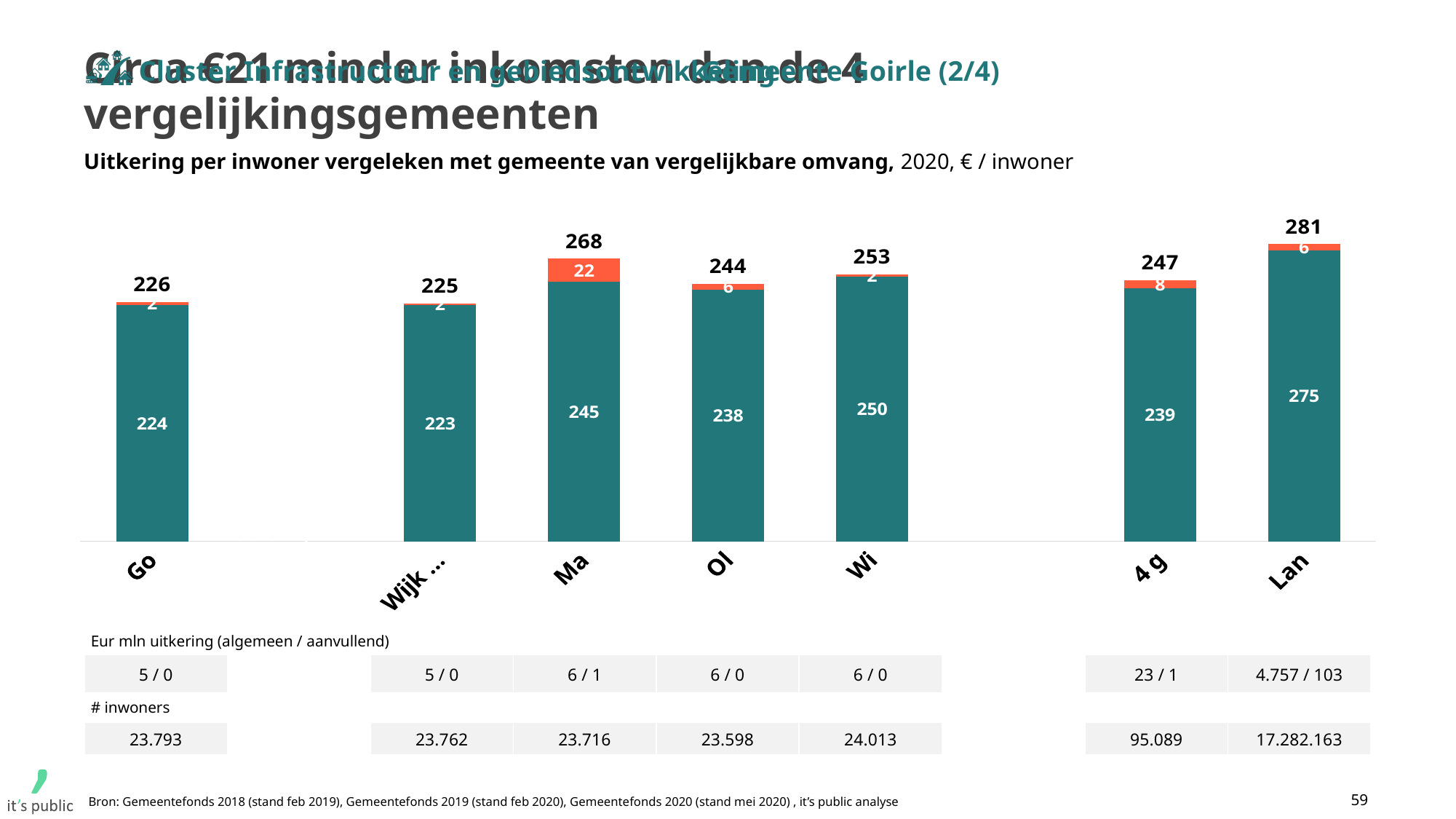
What is the value of the teal (lower) segment of the bar for Go? 224 What is the total value printed above the bar for Ma? 268 What kind of chart is shown on the slide? stacked bar chart What is the value of the orange (upper) segment of the bar for Ma? 22 How much larger is the orange segment for Ma than the orange segment for 4 g? 14 Which category has the highest total value? Lan What is the difference between the total for Lan and the total for Go? 55 In what unit are the chart values expressed, according to the subtitle? € / inwoner How many bars (categories) are plotted in the chart? 7 Which has the larger total value, Ol or Wi? Wi What is the value of the teal (lower) segment of the bar for Lan? 275 Which category has the lowest total value? Wijk ...